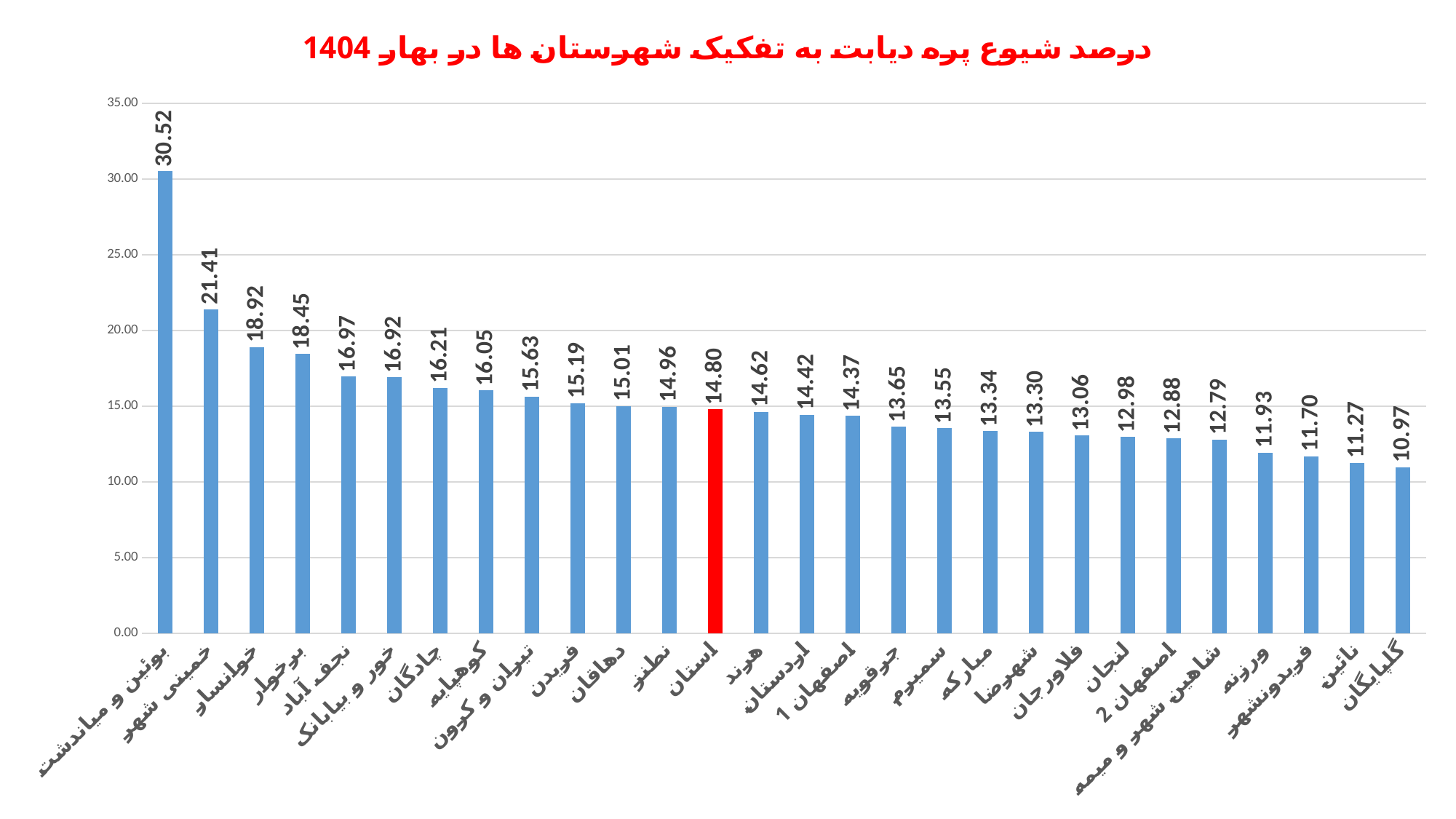
How many bars are plotted in the chart? 28 What is the value for خمینی شهر? 21.41 Which category has the lowest value? گلپایگان What is the value for استان (the red bar)? 14.80 What is the value for بوئین و میاندشت? 30.52 Which is larger, the value for نجف آباد or the value for چادگان? نجف آباد What is the difference between the values for بوئین و میاندشت and خمینی شهر? 9.11 Which bar is coloured red instead of blue? استان Do the values rise or fall moving from left to right along the x axis? fall What type of chart is shown on the slide? bar chart Which category has the highest value? بوئین و میاندشت What is the value for گلپایگان? 10.97